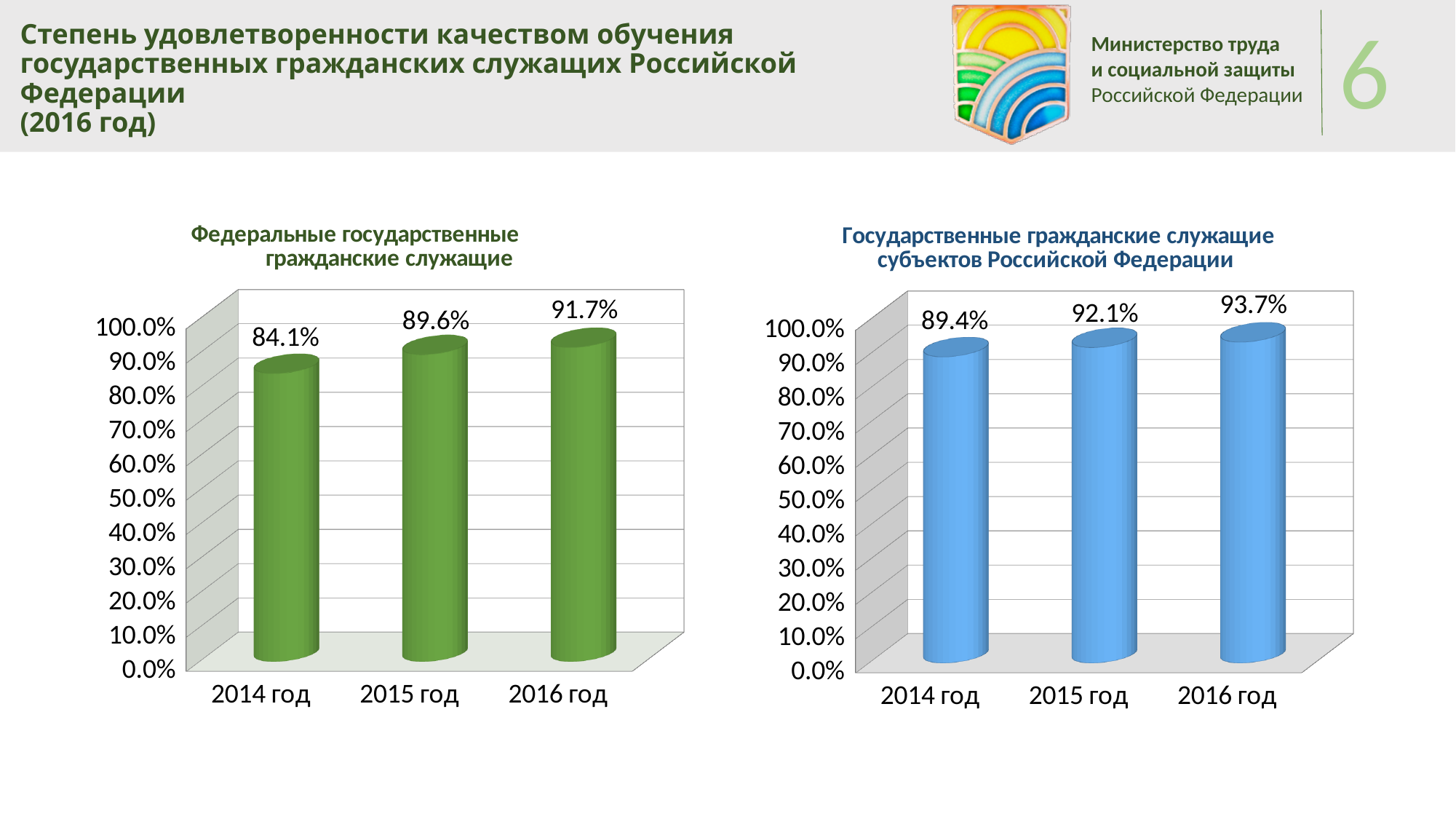
In the left chart (Федеральные государственные гражданские служащие), what is the value for 2016 год? 91.7% In the right chart (Государственные гражданские служащие субъектов Российской Федерации), what is the difference between the values for 2015 год and 2014 год? 2.7% In the left chart (Федеральные государственные гражданские служащие), what is the value for 2014 год? 84.1% In the left chart (Федеральные государственные гражданские служащие), what is the difference between the values for 2016 год and 2014 год? 7.6% In the left chart (Федеральные государственные гражданские служащие), which year has the highest value? 2016 год What kind of chart is the right chart (Государственные гражданские служащие субъектов Российской Федерации)? bar chart In the left chart (Федеральные государственные гражданские служащие), which is larger: the value for 2015 год or 2014 год? 2015 год In the right chart (Государственные гражданские служащие субъектов Российской Федерации), do the values rise or fall from 2014 год to 2016 год? rise In the right chart (Государственные гражданские служащие субъектов Российской Федерации), which year has the lowest value? 2014 год In the right chart (Государственные гражданские служащие субъектов Российской Федерации), what is the value for 2015 год? 92.1% How many years are shown in the left chart (Федеральные государственные гражданские служащие)? 3 In the right chart (Государственные гражданские служащие субъектов Российской Федерации), what is the value for 2016 год? 93.7%